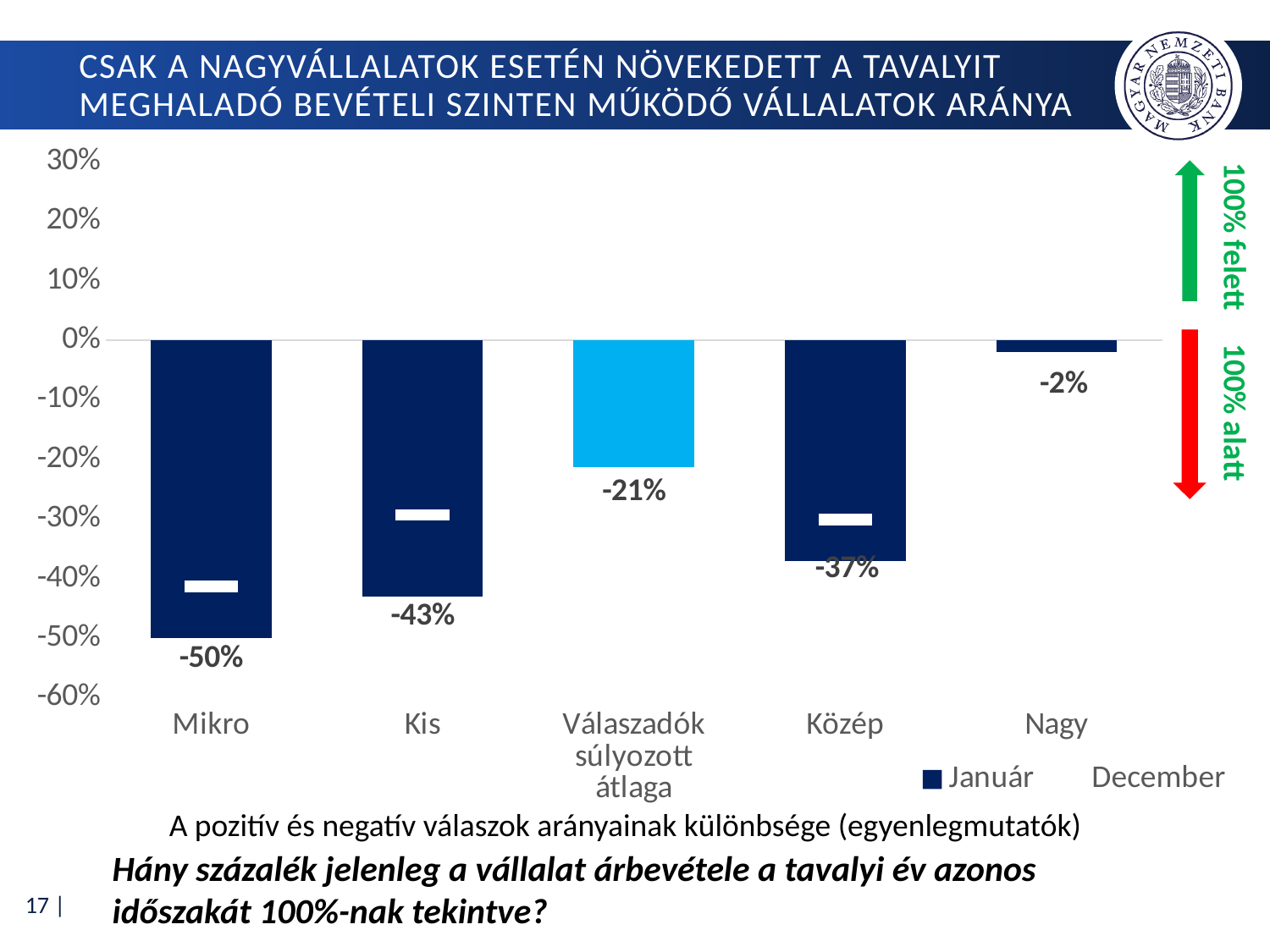
Which has a higher Január value, Közép or Kis? Közép How many categories are shown on the x axis? 5 What is the Január value for Válaszadók súlyozott átlaga? -21% How many series does the legend list? 2 What is the Január value for Kis? -43% Is the December value for Mikro greater or less than -30%? less What is the Január value for Mikro? -50% What is the Január value for Nagy? -2% What kind of chart is shown on the slide? bar chart What is the difference between the Január values for Mikro and Kis? 7 percentage points Which category has the highest Január value? Nagy Which category has the lowest Január value? Mikro